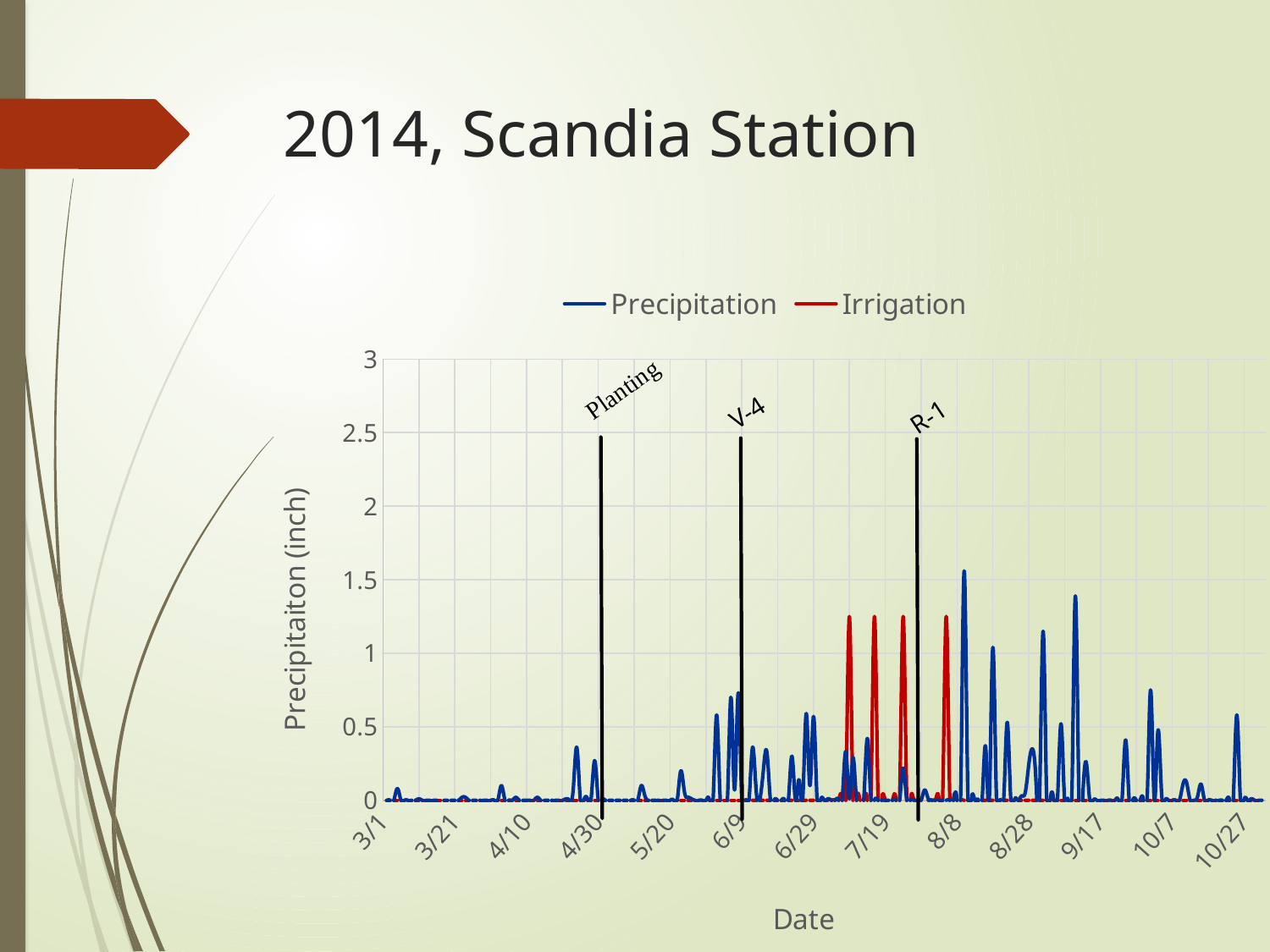
What kind of chart is shown on the slide? line chart Does any Precipitation value exceed 2 inches? no Are the Irrigation peaks greater or less than 1? greater Is the highest Precipitation peak greater or less than 2? less How many Irrigation events (red peaks) are shown on the chart? 4 What are the two series named in the legend? Precipitation and Irrigation How many series does the legend list? 2 Which series reaches the higher peak value, Precipitation or Irrigation? Precipitation What are the labels on the three vertical black lines drawn on the chart? Planting, V-4, R-1